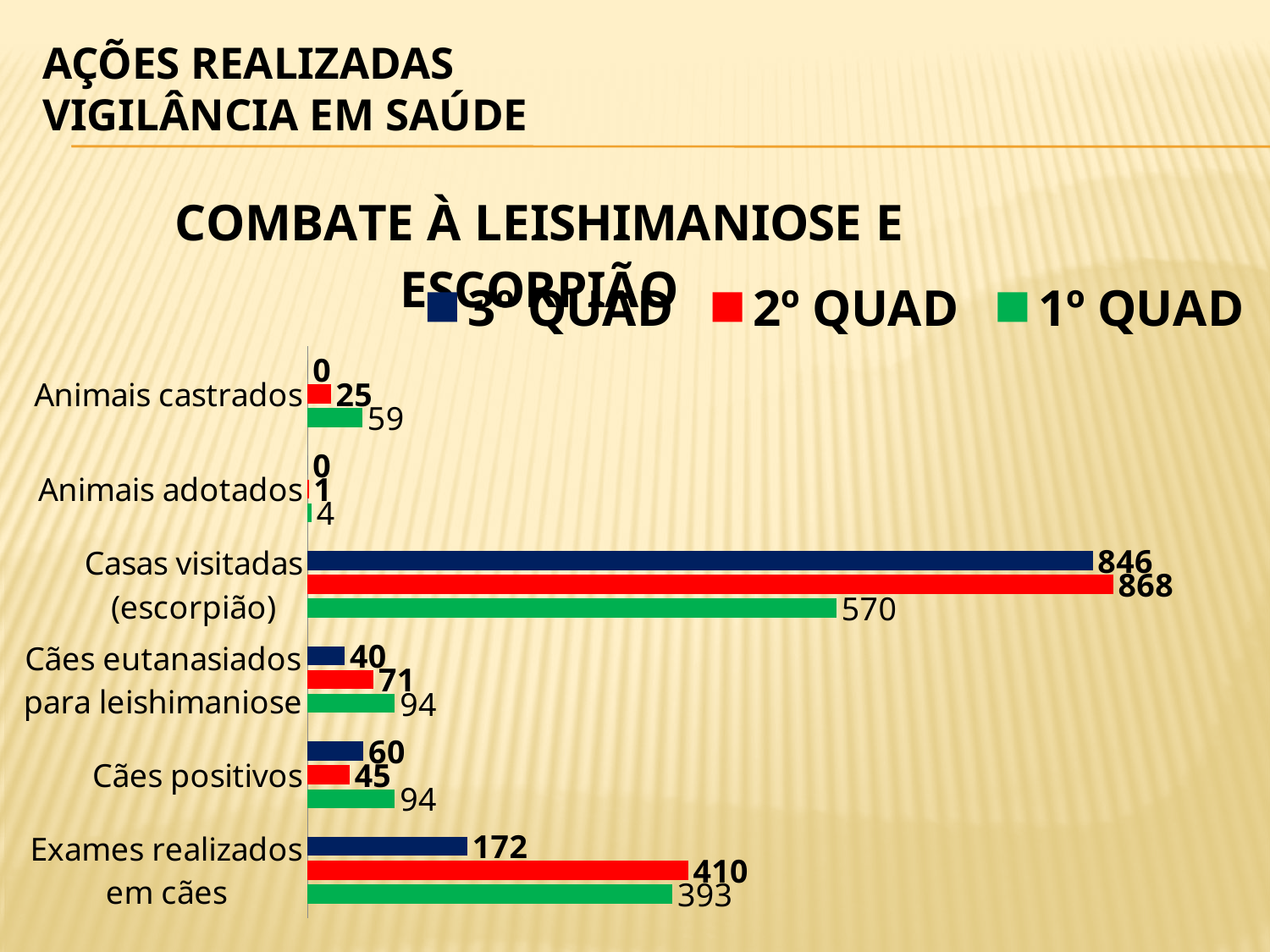
Which category has the highest value for 3º QUAD? Casas visitadas (escorpião) Which series has the lowest value in the category Exames realizados em cães? 3º QUAD How many categories are shown on the chart? 6 What is the value for 3º QUAD in the category Cães positivos? 60 What is the value for 1º QUAD in the category Exames realizados em cães? 393 Which colour represents the 1º QUAD series in the legend? green What is the value for 2º QUAD in the category Casas visitadas (escorpião)? 868 Which is larger for Cães eutanasiados para leishimaniose: the 2º QUAD value or the 3º QUAD value? 2º QUAD What is the value for 2º QUAD in the category Animais castrados? 25 How many series does the legend list? 3 What is the difference between the 2º QUAD and 3º QUAD values for Exames realizados em cães? 238 What type of chart is shown on the slide? bar chart